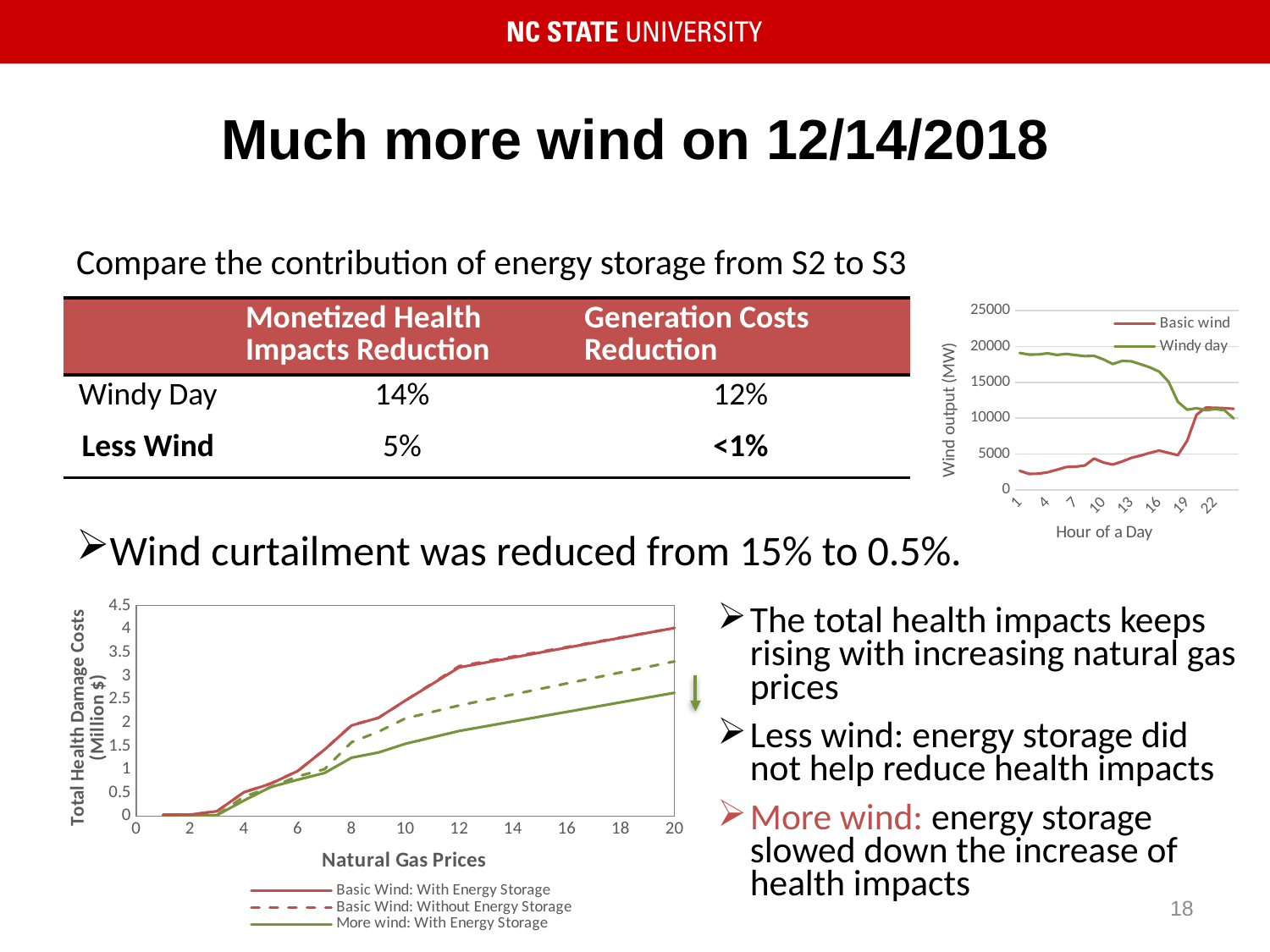
What kind of chart is the 'Total Health Damage Costs' chart at the bottom left of the slide? line chart In the 'Wind output (MW)' chart, which series has the higher value at hour 7, Basic wind or Windy day? Windy day In the 'Wind output (MW)' chart, is the value for Basic wind at hour 1 greater or less than 5000? less In the 'Total Health Damage Costs' chart, is the value for 'Basic Wind: With Energy Storage' at a natural gas price of 20 greater or less than 3.5? greater In the 'Wind output (MW)' chart, is the value for Windy day at hour 1 greater or less than 15000? greater In the 'Total Health Damage Costs' chart, which series is higher at a natural gas price of 20, 'Basic Wind: With Energy Storage' or 'More wind: With Energy Storage'? Basic Wind: With Energy Storage What kind of chart is the chart titled with the y-axis 'Wind output (MW)' in the top right of the slide? line chart In the 'Wind output (MW)' chart, does the Basic wind series generally rise or fall over the hours of the day? rise What is the x-axis title of the 'Total Health Damage Costs' chart? Natural Gas Prices How many series does the legend of the 'Wind output (MW)' chart list? 2 In the 'Wind output (MW)' chart, does the Windy day series generally rise or fall over the hours of the day? fall